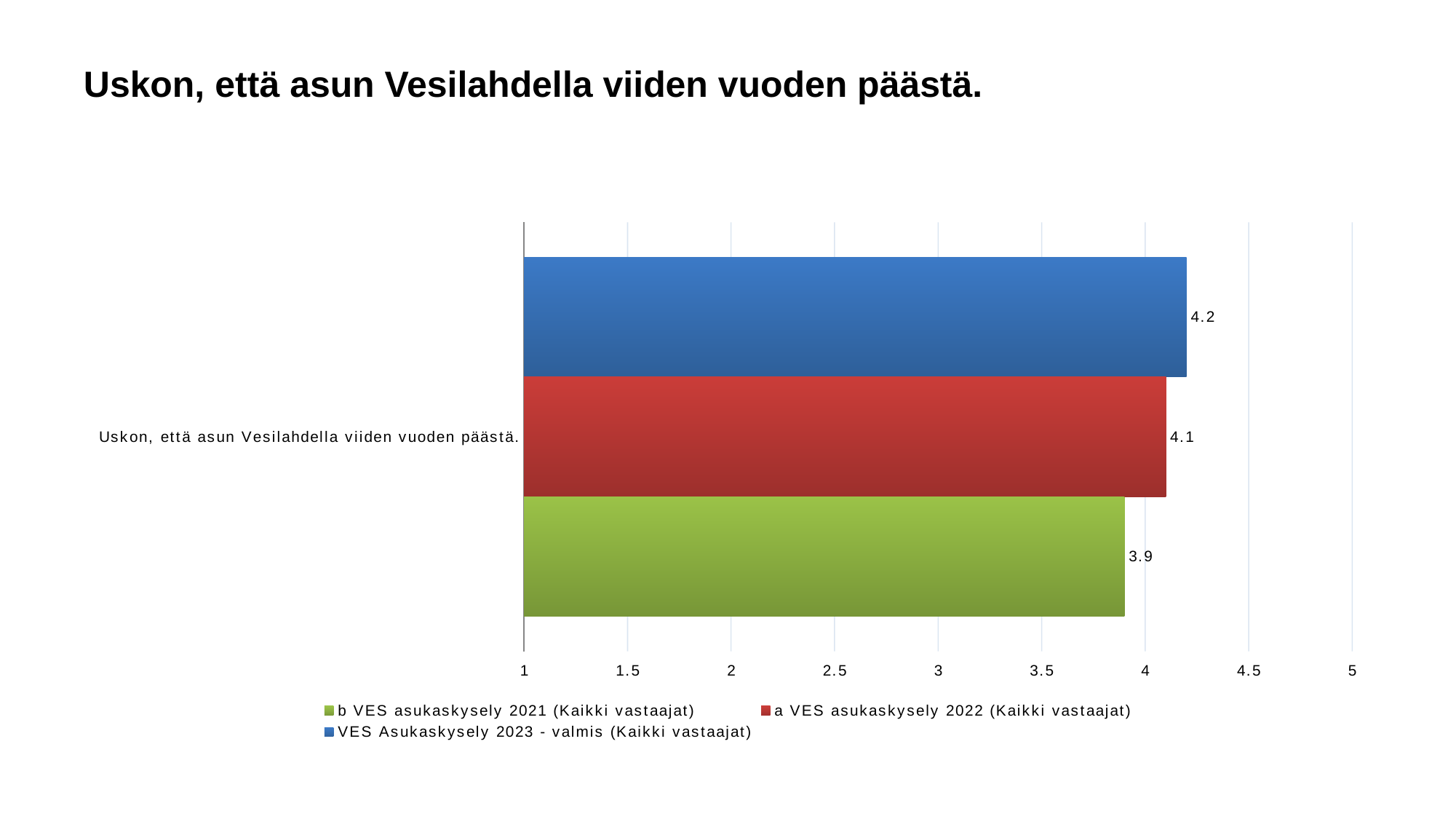
What kind of chart is shown on the slide? bar chart Is the value for the 2021 survey greater or less than 4? less What is the difference between the 2022 survey value and the 2021 survey value? 0.2 What is the value for the 2022 survey (a VES asukaskysely 2022) series? 4.1 What is the value for the 2023 survey (VES Asukaskysely 2023 - valmis) series? 4.2 What is the title of the chart? Uskon, että asun Vesilahdella viiden vuoden päästä. What is the difference between the 2023 survey value and the 2021 survey value? 0.3 Which survey year has the highest value? VES Asukaskysely 2023 - valmis (Kaikki vastaajat) Which survey year has the lowest value? b VES asukaskysely 2021 (Kaikki vastaajat) How many series does the legend list? 3 Which is larger, the value for the 2022 survey or the value for the 2021 survey? a VES asukaskysely 2022 (Kaikki vastaajat) What is the value for the 2021 survey (b VES asukaskysely 2021) series? 3.9